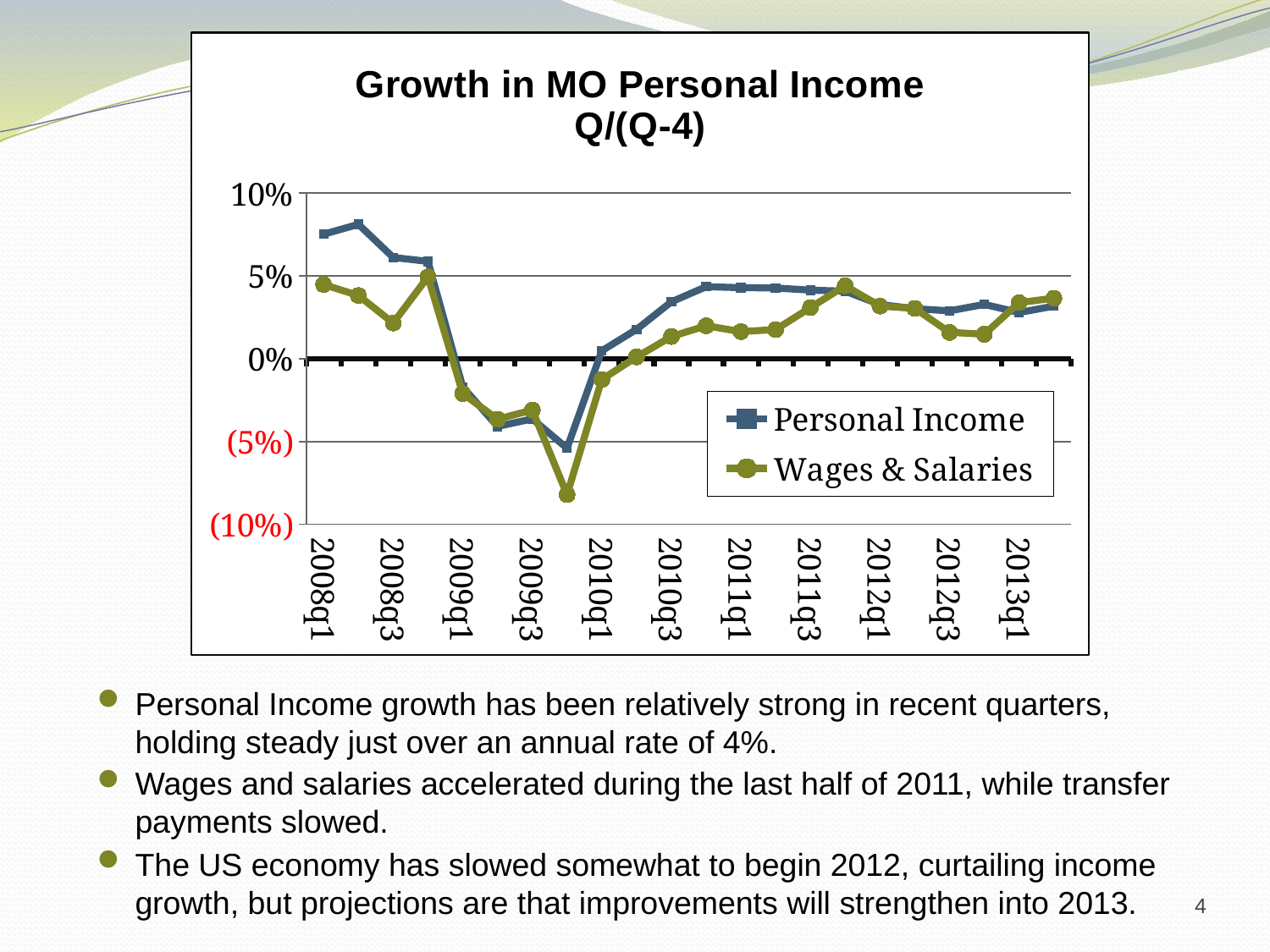
What is the title of the chart? Growth in MO Personal Income Q/(Q-4) In which year does the Wages & Salaries series reach its lowest value? 2009 What are the two series named in the legend? Personal Income and Wages & Salaries What kind of chart is shown on the slide? Line chart At 2008q1, which series has the higher value, Personal Income or Wages & Salaries? Personal Income Is the value for Personal Income at 2008q1 greater or less than 5%? greater Does the Personal Income series rise or fall between 2008q1 and 2009q3? Fall Is the value for Wages & Salaries at 2011q1 greater or less than 5%? less How many series does the legend list? 2 Is the value for Wages & Salaries at 2008q1 greater or less than 5%? less At 2010q3, which series has the higher value, Personal Income or Wages & Salaries? Personal Income